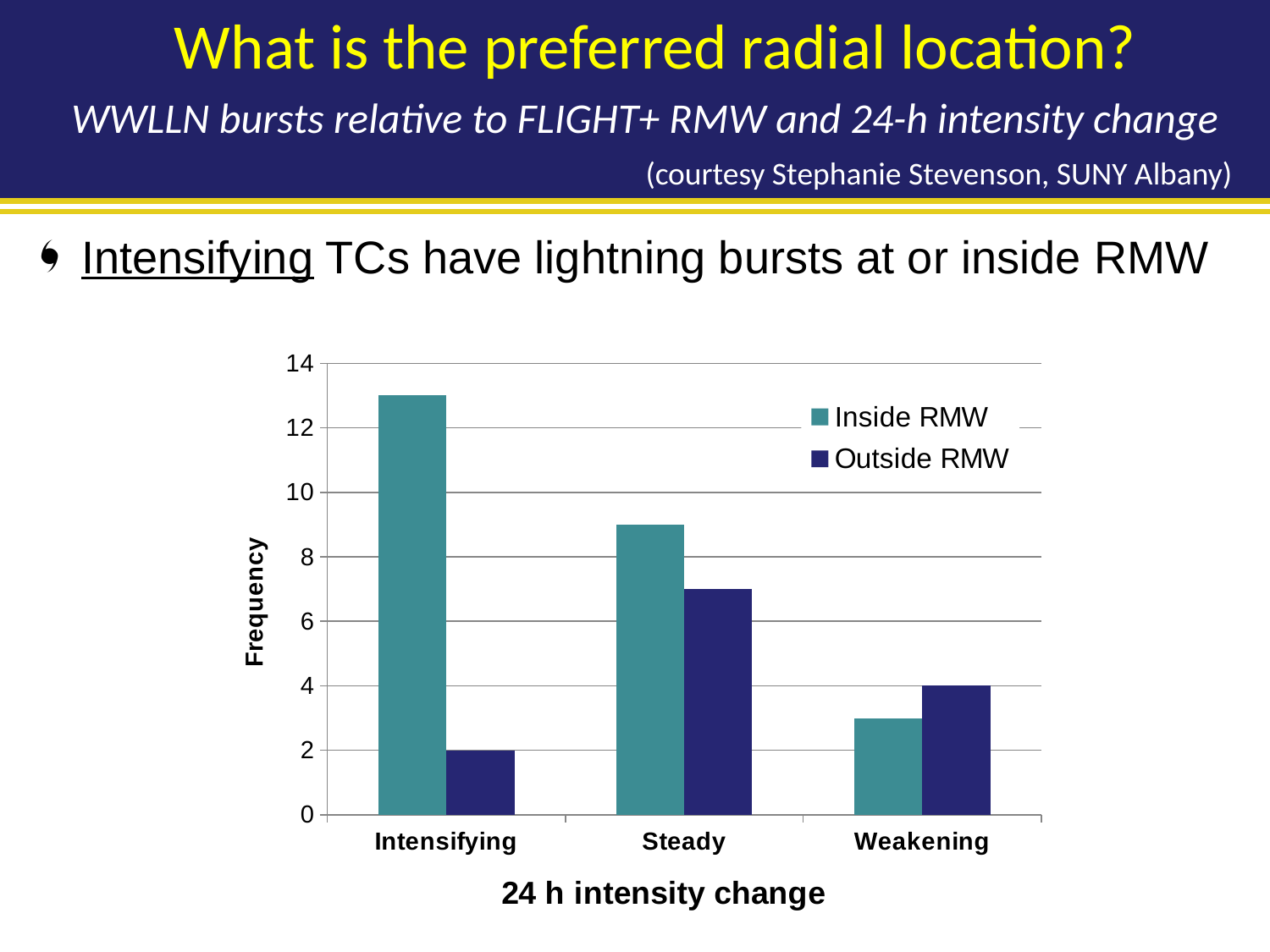
Is the Inside RMW value for Weakening greater or less than 4? less What is the difference between the Outside RMW frequency for Weakening and for Intensifying? 2 What is the Outside RMW frequency for Weakening? 4 What type of chart is shown on the slide? bar chart Which category has the highest Inside RMW frequency? Intensifying How many categories are shown on the x axis? 3 Is the Inside RMW value for Steady greater or less than 8? greater How many series does the legend list? 2 Is the Inside RMW value for Intensifying greater or less than 12? greater For Steady, which is larger: Inside RMW or Outside RMW? Inside RMW What is the Outside RMW frequency for Intensifying? 2 Which category has the lowest Outside RMW frequency? Intensifying